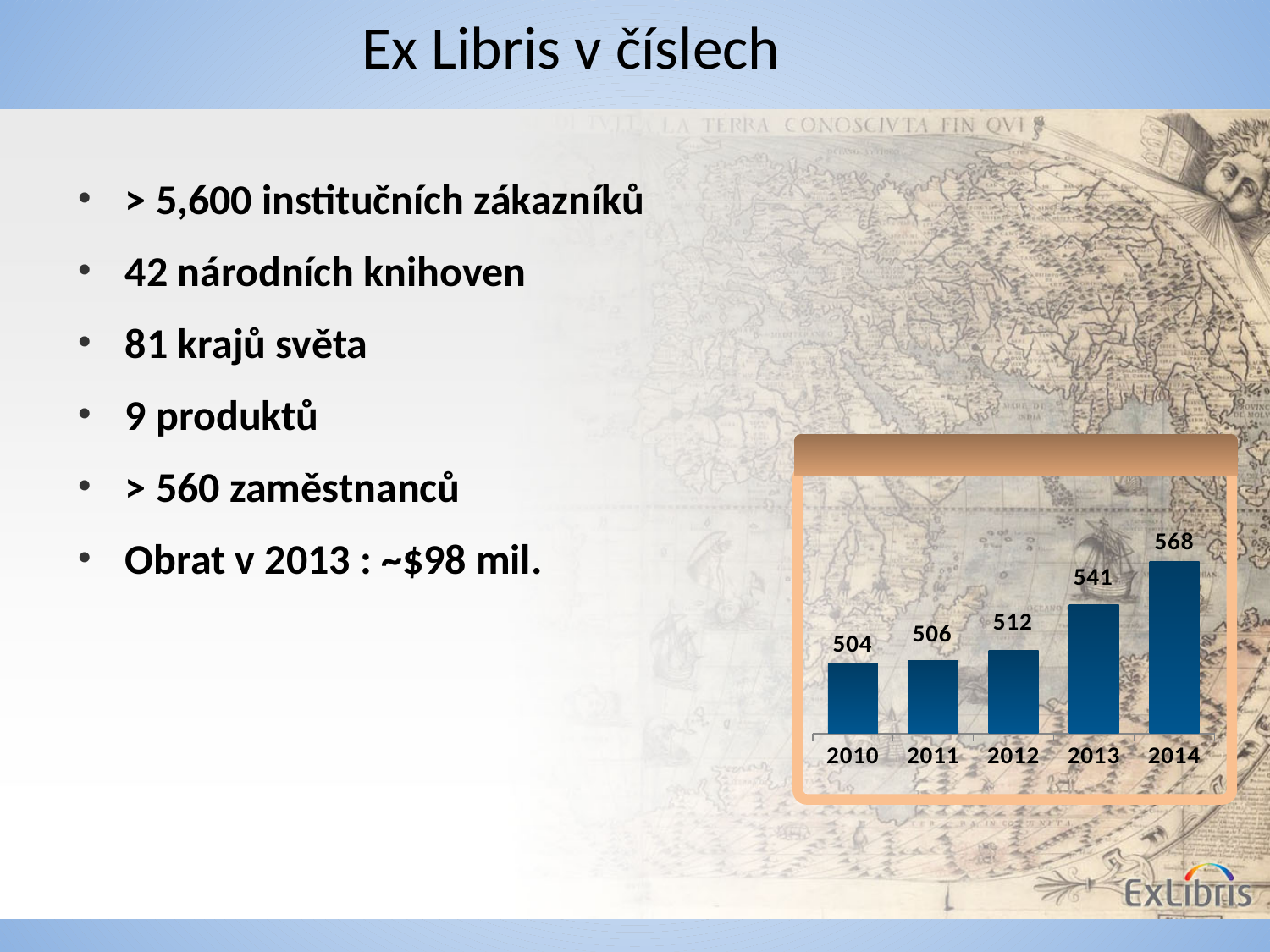
Which year has the lowest value in the bar chart? 2010 What is the value shown for 2012 in the bar chart? 512 What colour are the bars in the chart? blue What is the value shown for 2010 in the bar chart? 504 How many years are shown on the x axis of the bar chart? 5 Which year has the highest value in the bar chart? 2014 Which is larger in the bar chart, the value for 2013 or the value for 2012? 2013 What is the value shown for 2014 in the bar chart? 568 What kind of chart is shown on the slide? bar chart What is the difference between the values for 2014 and 2013 in the bar chart? 27 What is the difference between the values for 2011 and 2010 in the bar chart? 2 Do the values in the bar chart rise or fall from 2010 to 2014? rise